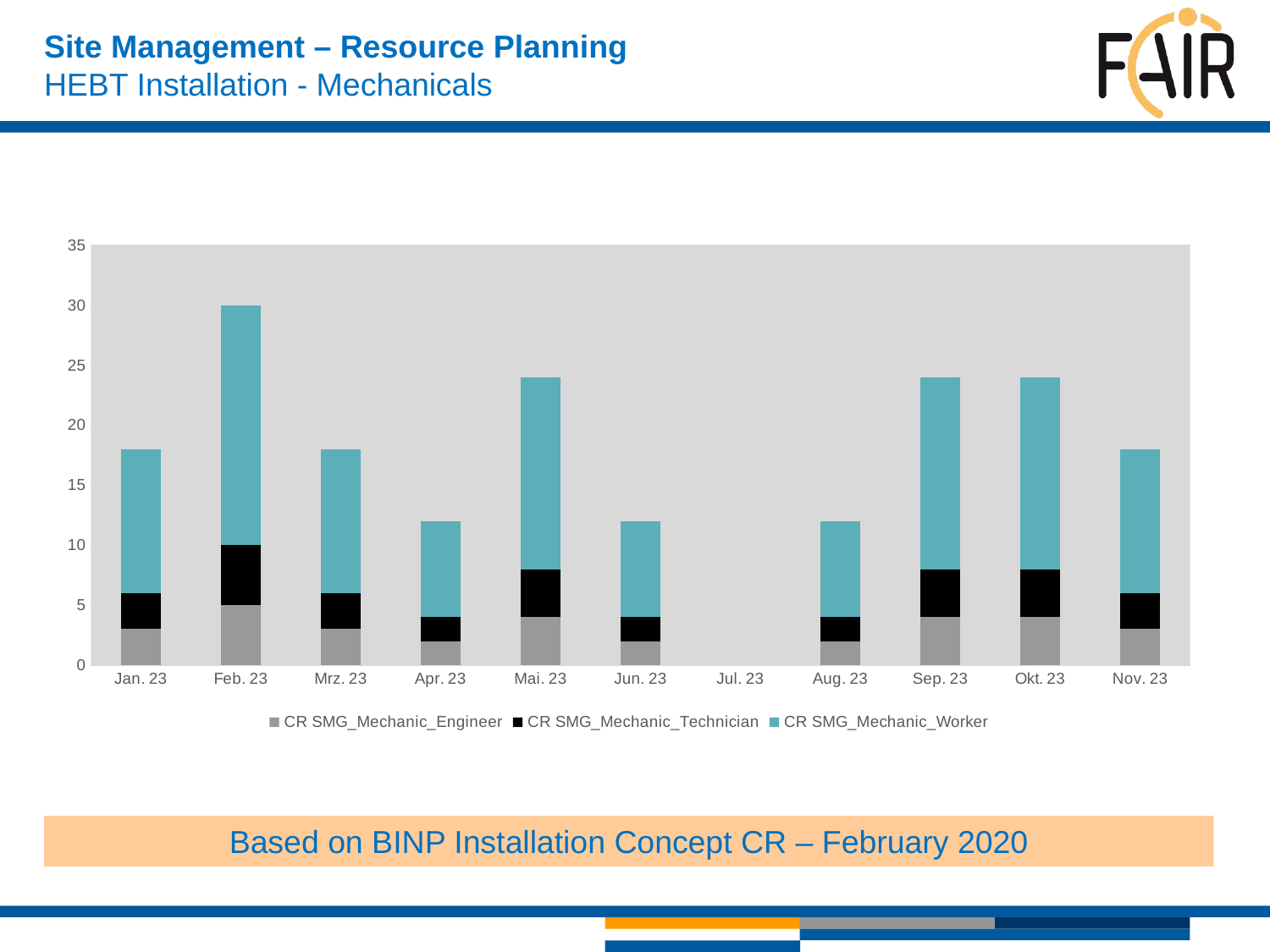
Which month has the lowest total (no bar shown)? Jul. 23 What is the total of the stacked bar for Feb. 23? 30 Is the total for Jan. 23 greater or less than 15? greater How many series does the legend list? 3 Is the total for Sep. 23 greater or less than 20? greater Is the total for Apr. 23 greater or less than 15? less What is the value of CR SMG_Mechanic_Engineer for Feb. 23? 5 How many months are shown on the x axis? 11 What kind of chart is shown on the slide? Stacked bar chart Which series is shown in black in the legend? CR SMG_Mechanic_Technician Which month has the highest total stacked bar? Feb. 23 Which month has the larger total, Feb. 23 or Mai. 23? Feb. 23